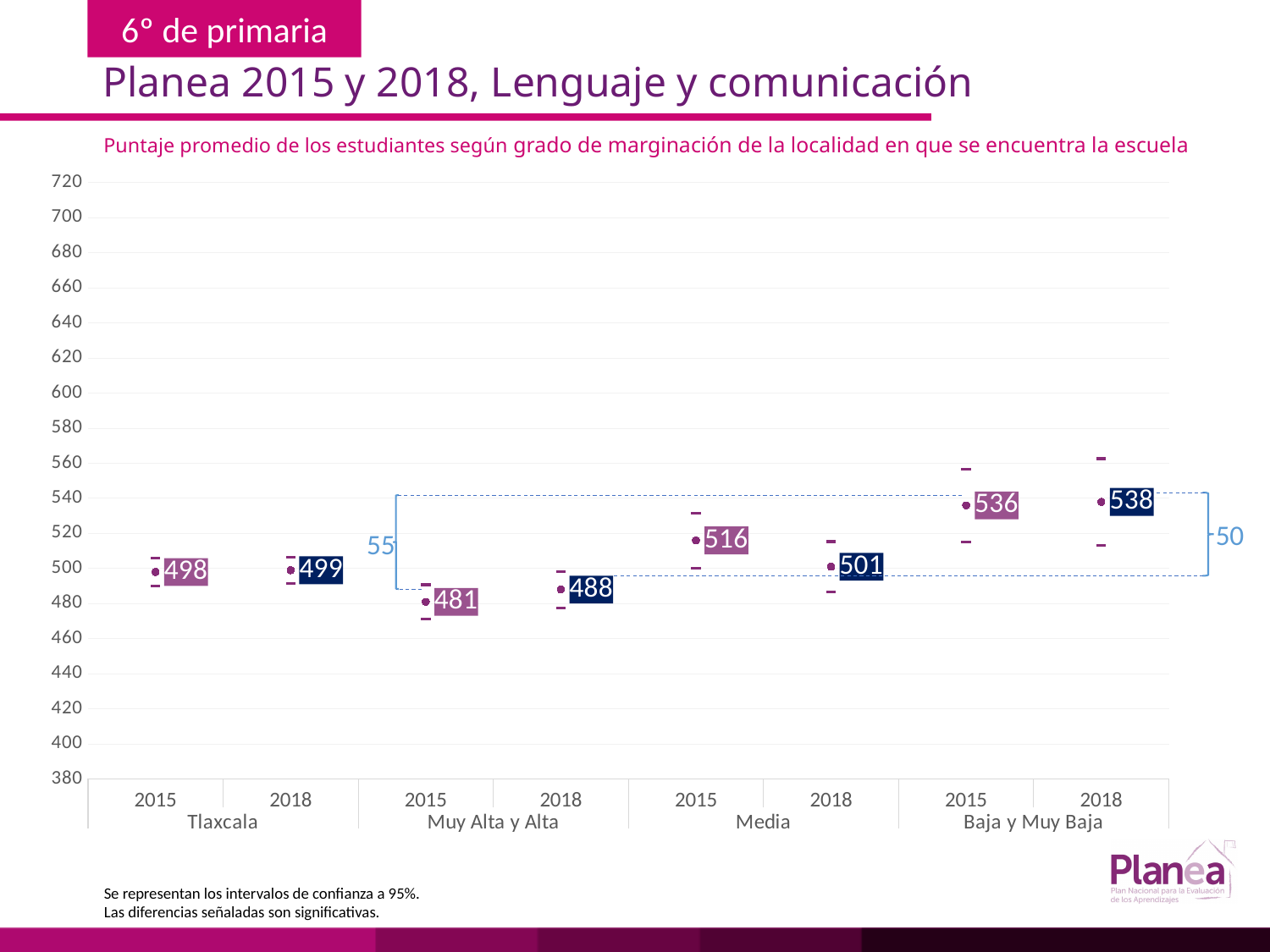
What confidence level do the intervals shown on the chart represent, according to the note? 95% What is the average score for Tlaxcala in 2015? 498 Which group and year has the lowest average score on the chart? Muy Alta y Alta, 2015 Did the Muy Alta y Alta group's score rise or fall from 2015 to 2018? Rise What is the average score for the Muy Alta y Alta marginación group in 2018? 488 What is the difference between the 2018 scores of the Baja y Muy Baja group and the Muy Alta y Alta group? 50 What is the average score for the Baja y Muy Baja marginación group in 2018? 538 Which group and year has the highest average score on the chart? Baja y Muy Baja, 2018 Which is larger, the Media group's score in 2015 or in 2018? 2015 How many data points (group-year combinations) are plotted on the chart? 8 What is the average score for the Media marginación group in 2015? 516 What is the difference between the 2015 scores of the Baja y Muy Baja group and the Muy Alta y Alta group? 55